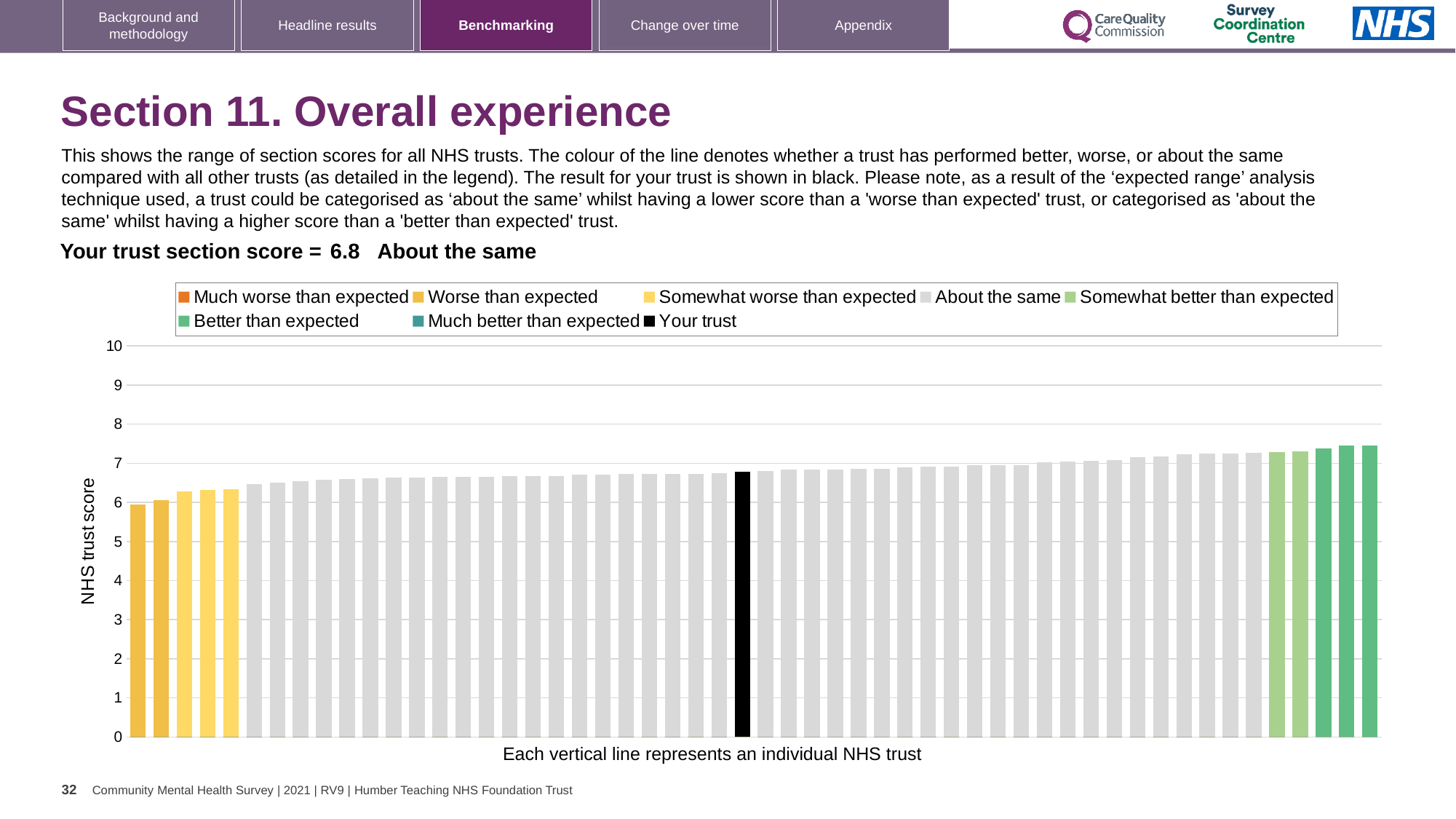
Is the value for your trust (the black bar) greater or less than 6? greater How many entries does the chart legend list? 8 What kind of chart is used to show the range of section scores? Bar chart What is the label on the vertical axis of the chart? NHS trust score Do the trust scores rise or fall moving from left to right along the x axis? rise What is the section score for your trust shown on the slide? 6.8 Is the value for the highest-scoring trust (rightmost bar) greater or less than 8? less How many bars are coloured as 'Much worse than expected' (orange) in the chart? 0 Is the value for the lowest-scoring trust (leftmost bar) greater or less than 5? greater Which benchmarking category is your trust placed in for Section 11? About the same What colour is used for the bar representing your trust? Black Which bar is larger, the leftmost bar or the rightmost bar? the rightmost bar